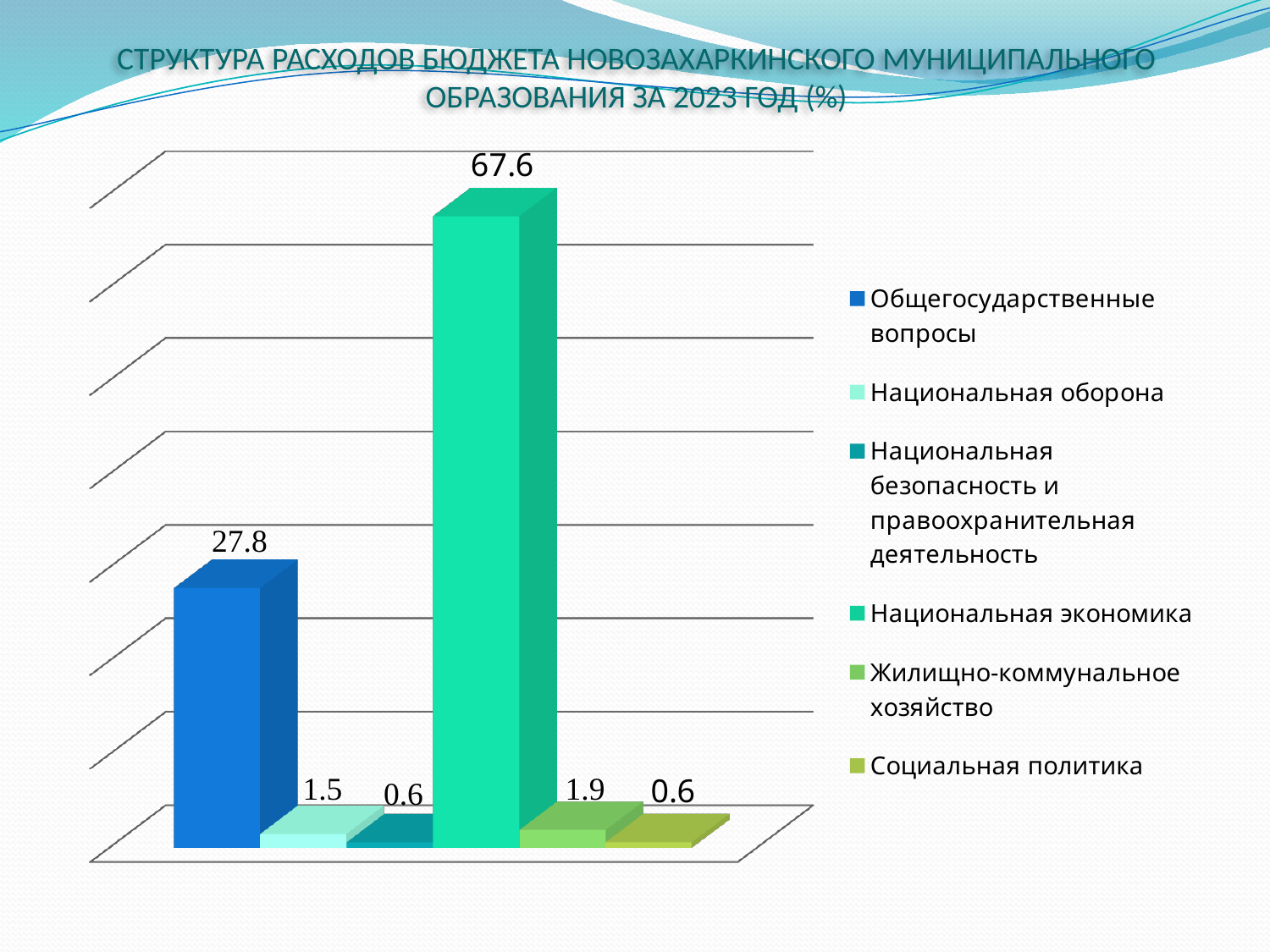
What kind of chart is shown on the slide? Bar chart What is the value for Жилищно-коммунальное хозяйство? 1.9 What is the value for Социальная политика? 0.6 What is the difference between the values for Национальная экономика and Общегосударственные вопросы? 39.8 What is the value for Национальная оборона? 1.5 What is the lowest value shown on the chart? 0.6 Which is larger, the value for Жилищно-коммунальное хозяйство or the value for Национальная оборона? Жилищно-коммунальное хозяйство What is the value for Национальная экономика? 67.6 Which category has the highest value? Национальная экономика How many series does the legend list? 6 What is the value for Общегосударственные вопросы? 27.8 What colour is the bar for Общегосударственные вопросы? Blue